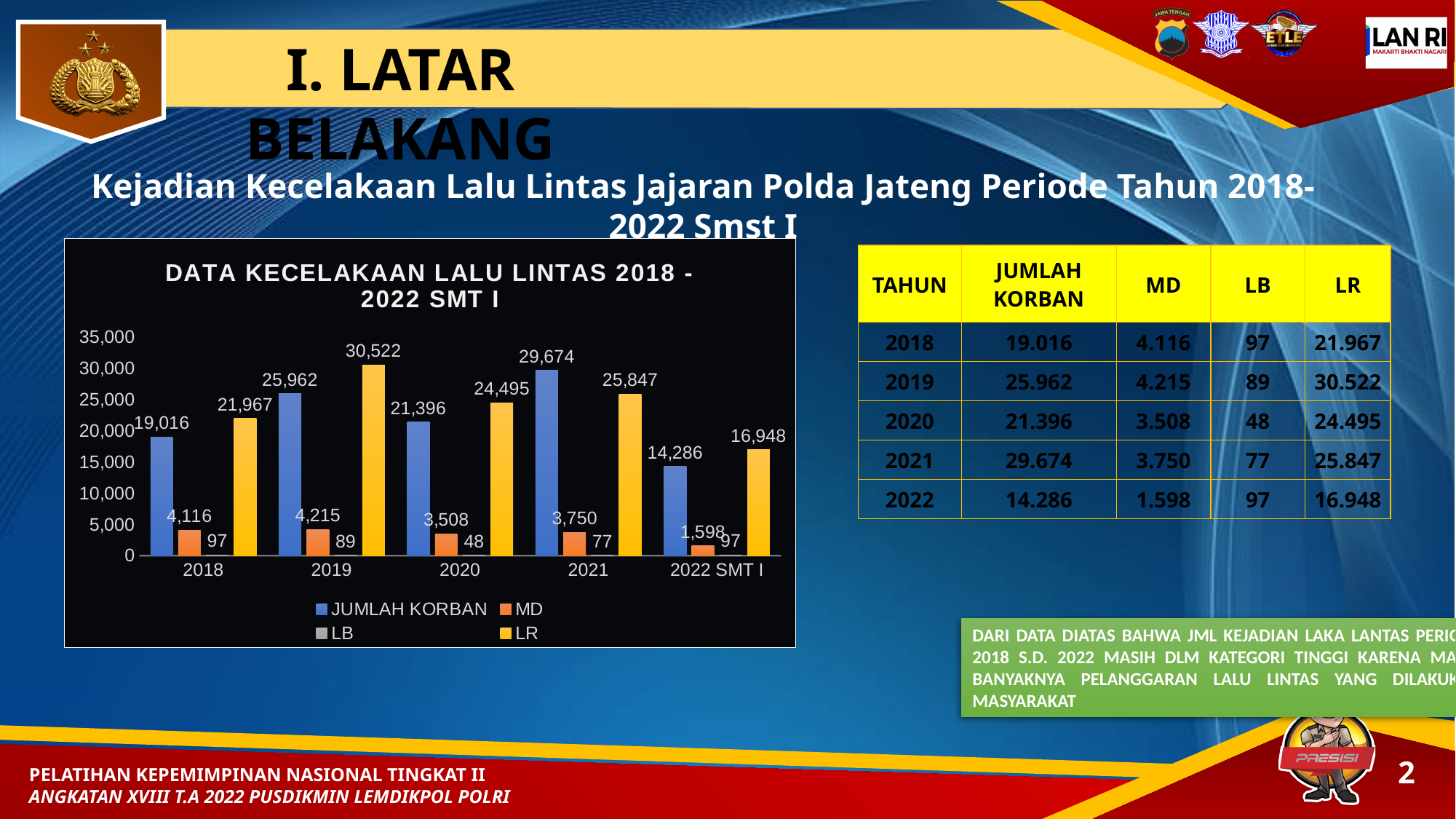
What is the value of JUMLAH KORBAN for 2019? 25,962 Which year has the highest LR value? 2019 How many categories are shown on the x axis of the chart? 5 What type of chart is shown on the slide? bar chart What is the difference between the JUMLAH KORBAN values for 2021 and 2020? 8,278 What is the value of LR for 2022 SMT I? 16,948 Is the JUMLAH KORBAN value for 2018 greater or less than 20,000? less How many series does the chart legend list? 4 Which is larger, the LR value for 2018 or the LR value for 2021? 2021 What is the title of the chart? DATA KECELAKAAN LALU LINTAS 2018 - 2022 SMT I Which category has the lowest JUMLAH KORBAN value? 2022 SMT I What is the value of MD for 2020? 3,508